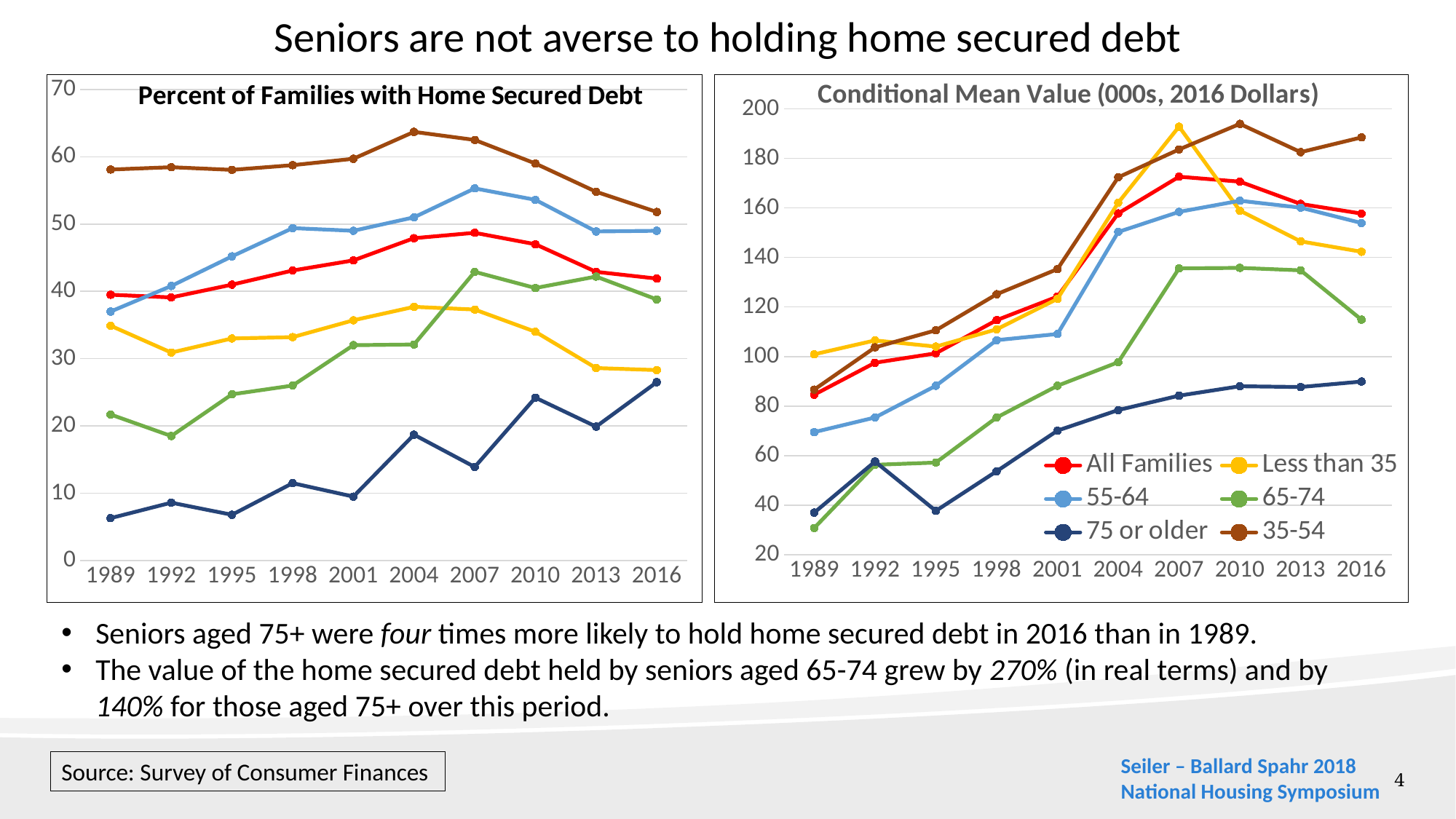
In the 'Percent of Families with Home Secured Debt' chart, is the brown line's value in 2004 greater or less than 60? greater In the 'Percent of Families with Home Secured Debt' chart, is the dark blue line's value in 1989 greater or less than 10? less In the 'Conditional Mean Value (000s, 2016 Dollars)' chart, is the value for 35-54 in 2010 greater or less than 180? greater In the 'Conditional Mean Value (000s, 2016 Dollars)' chart, which is larger in 2016: 55-64 or Less than 35? 55-64 How many years are shown on the x axis of the 'Conditional Mean Value (000s, 2016 Dollars)' chart? 10 In the 'Conditional Mean Value (000s, 2016 Dollars)' chart, does the 75 or older series generally rise or fall from 1989 to 2016? rise How many series does the legend of the 'Conditional Mean Value (000s, 2016 Dollars)' chart list? 6 In the 'Conditional Mean Value (000s, 2016 Dollars)' chart, which series has the lowest value in 2016? 75 or older What is the title of the chart on the left of the slide? Percent of Families with Home Secured Debt In the 'Conditional Mean Value (000s, 2016 Dollars)' chart, which series has the highest value in 2007? Less than 35 What kind of chart is the 'Percent of Families with Home Secured Debt' chart? line chart